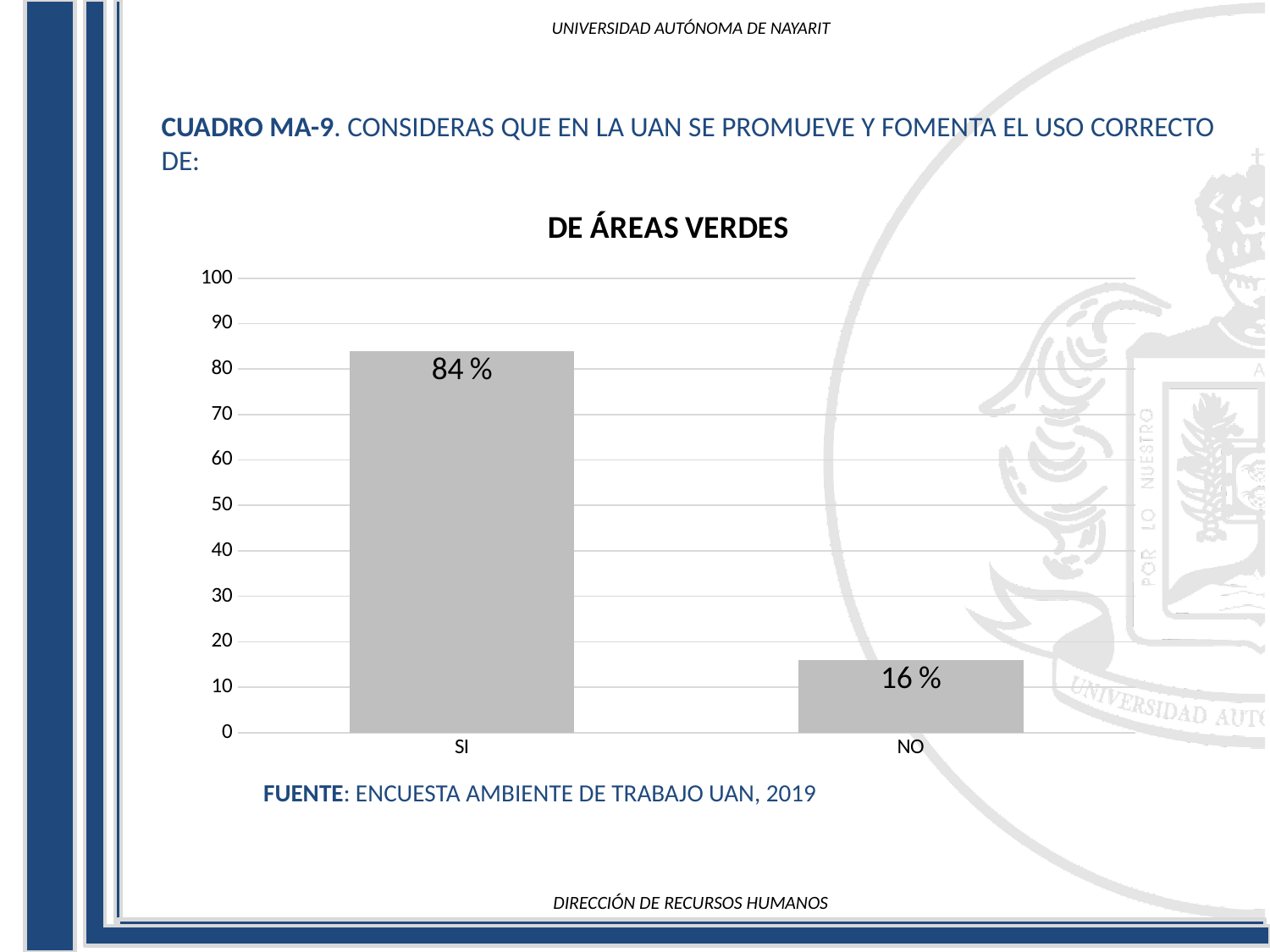
Is the value for NO greater or less than 20? less Which is larger, the value for SI or the value for NO? SI What is the difference between the values for SI and NO? 68 % What is the value for SI? 84 % What is the maximum value shown on the y axis? 100 How many categories are shown on the x axis? 2 What is the value for NO? 16 % Is the value for SI greater or less than 80? greater Which category has the lowest value? NO What kind of chart is shown? bar chart What is the title of the chart? DE ÁREAS VERDES Which category has the highest value? SI